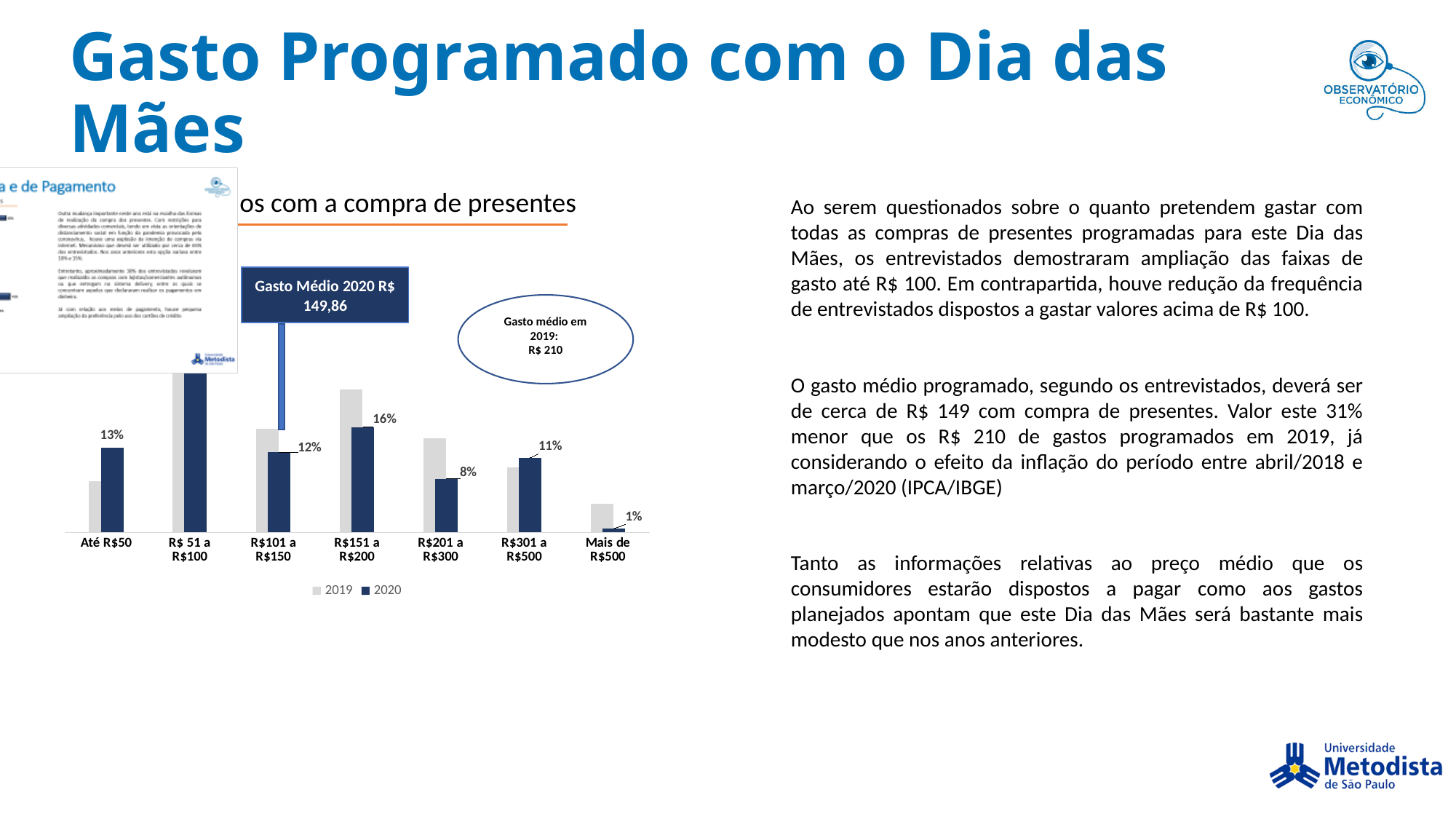
How many series does the legend list? 2 What is the 2020 value for the 'R$301 a R$500' category? 11% What is the 2020 value for the 'R$151 a R$200' category? 16% What kind of chart is shown on the slide? Bar chart What is the 2020 value for the 'Até R$50' category? 13% What is the difference between the 2020 values for 'R$151 a R$200' and 'R$201 a R$300'? 8% What is the 2020 value for the 'Mais de R$500' category? 1% Which category has the lowest 2020 value? Mais de R$500 What is the 2020 value for the 'R$201 a R$300' category? 8% Which category has the highest 2020 bar? R$ 51 a R$100 For the 'R$151 a R$200' category, which series has the taller bar, 2019 or 2020? 2019 How many spending categories are shown on the x axis? 7